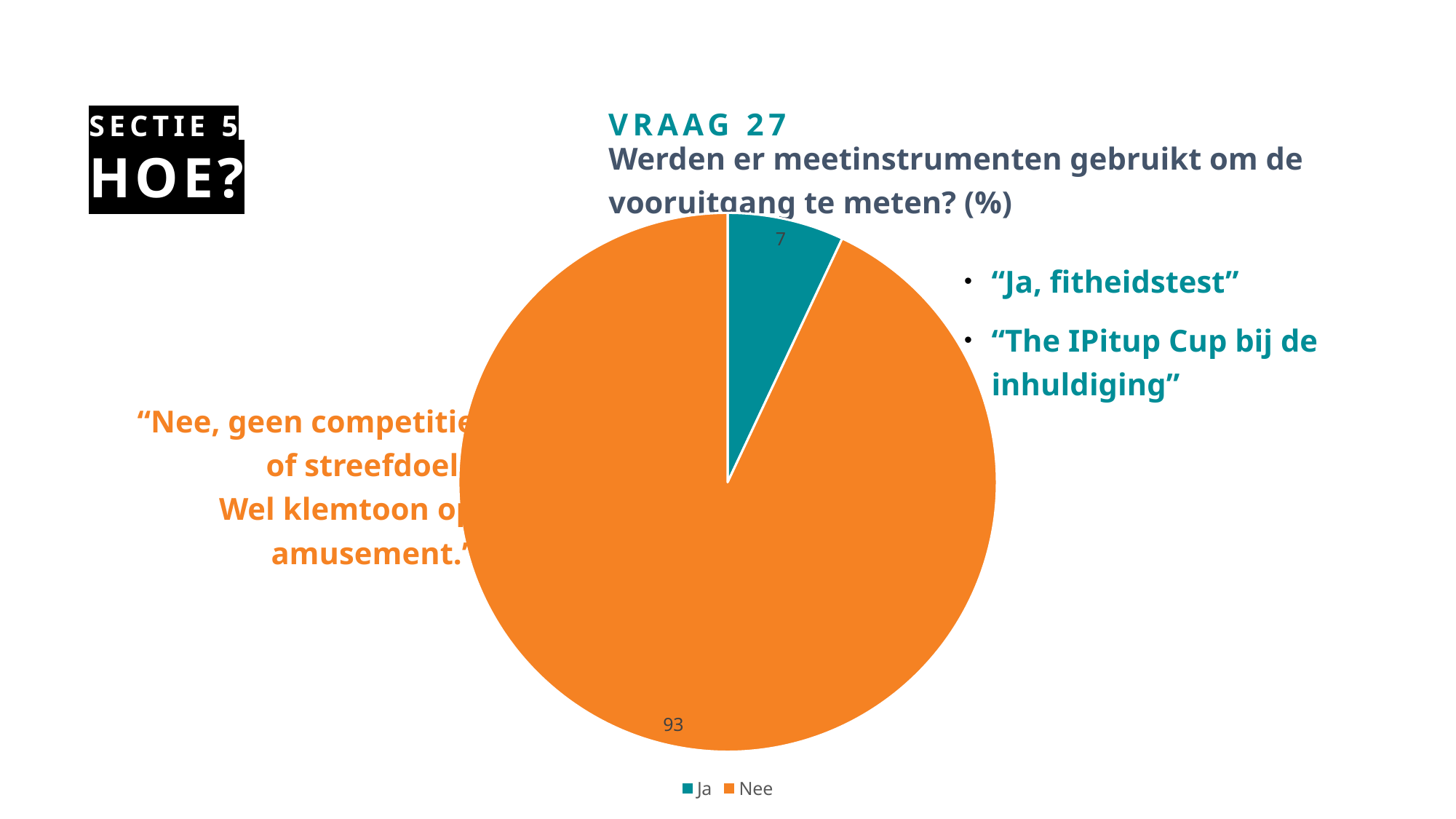
What is the value for "Ja" in the pie chart? 7 How many entries does the legend list? 2 Which category has the smallest slice in the pie chart? Ja What colour is the "Nee" slice in the pie chart? orange What is the difference between the values for "Nee" and "Ja"? 86 What colour is the "Ja" slice in the pie chart? teal How many categories does the pie chart show? 2 Which is larger, the value for "Ja" or the value for "Nee"? Nee Which category has the largest slice in the pie chart? Nee What is the value for "Nee" in the pie chart? 93 What kind of chart is shown on the slide? pie chart What share of the pie does the "Ja" slice represent? 7%